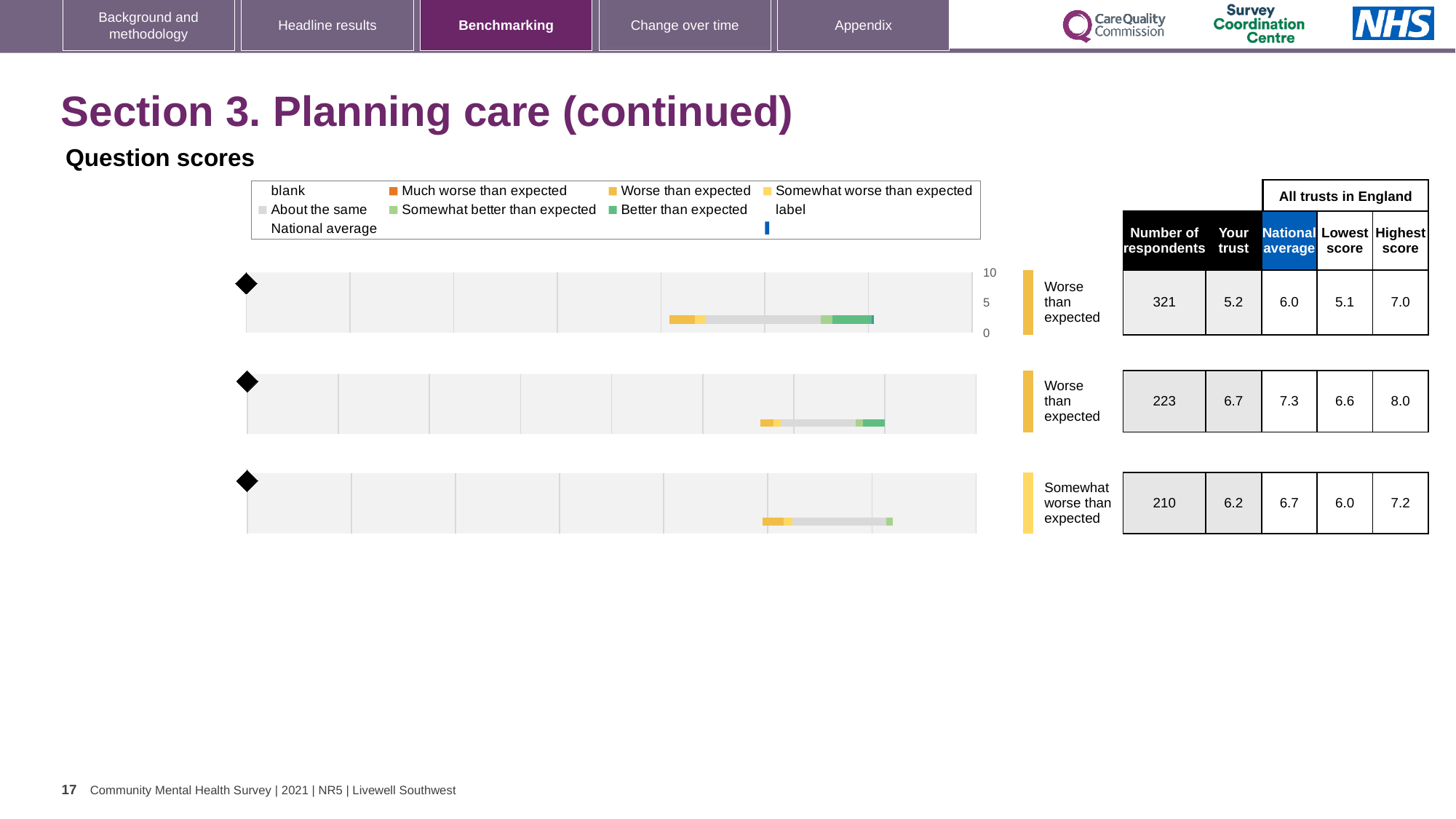
In the third (bottom) chart row, what is the highest score among all trusts in England? 7.2 What type of chart is used to show the question scores? Bar chart Which chart row has the highest number of respondents? The first (top) row, with 321 In the second (middle) chart row, what is the lowest score among all trusts in England? 6.6 In the first (top) chart row, what is the difference between the national average and the 'Your trust' score? 0.8 In the first (top) chart row, what is the 'Your trust' score? 5.2 What is the maximum value shown on the score axis of the top chart? 10 In the first (top) chart row, what is the number of respondents shown in the table? 321 How many question score chart rows are shown on the slide? 3 Is the 'Your trust' score higher in the second (middle) row or the third (bottom) row? The second (middle) row (6.7) What benchmark rating label is shown next to the third (bottom) chart row? Somewhat worse than expected In the second (middle) chart row, what is the national average score? 7.3